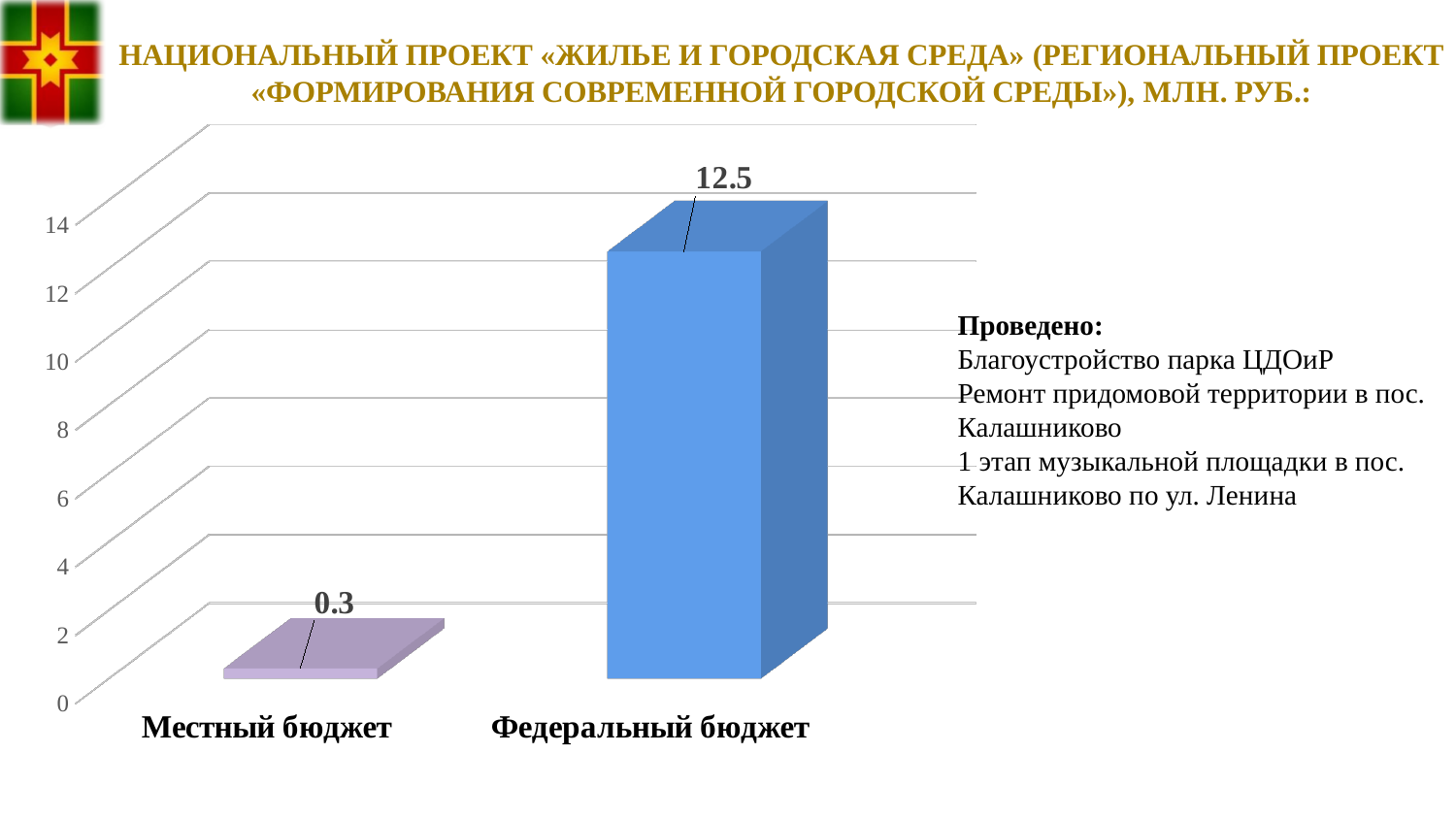
What kind of chart is shown on the slide? bar chart Which category has the highest value? Федеральный бюджет What is the difference between the values for Федеральный бюджет and Местный бюджет? 12.2 What is the highest tick value shown on the vertical axis? 14 Which is larger, the value for Местный бюджет or the value for Федеральный бюджет? Федеральный бюджет Is the value for Федеральный бюджет greater or less than 10? greater What is the value for Федеральный бюджет? 12.5 Is the value for Местный бюджет greater or less than 2? less Which category has the lowest value? Местный бюджет What is the value for Местный бюджет? 0.3 How many categories are shown on the chart? 2 What is the total of the two bars on the chart? 12.8